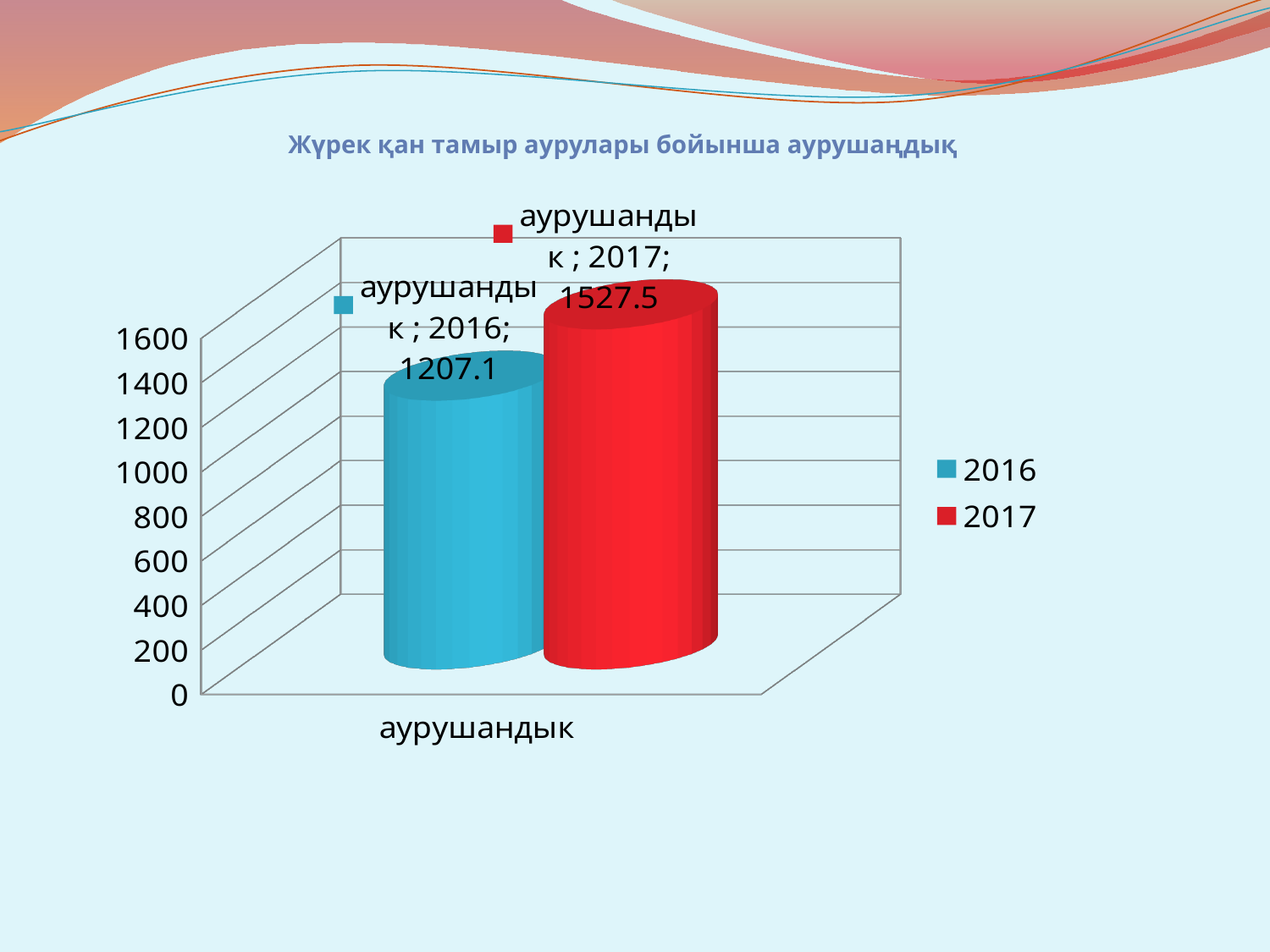
How many series does the legend list? 2 Is the value for 2016 greater or less than 1400? less How many categories are shown on the x axis? 1 Which year has the higher value, 2016 or 2017? 2017 What is the value for 2017 in the chart? 1527.5 Which series has the highest value in the chart? 2017 What is the difference between the 2017 value and the 2016 value? 320.4 Which series has the lowest value in the chart? 2016 What colour is the bar for 2017? red What is the value for 2016 in the chart? 1207.1 What kind of chart is shown on the slide? bar chart Is the value for 2017 greater or less than 1400? greater